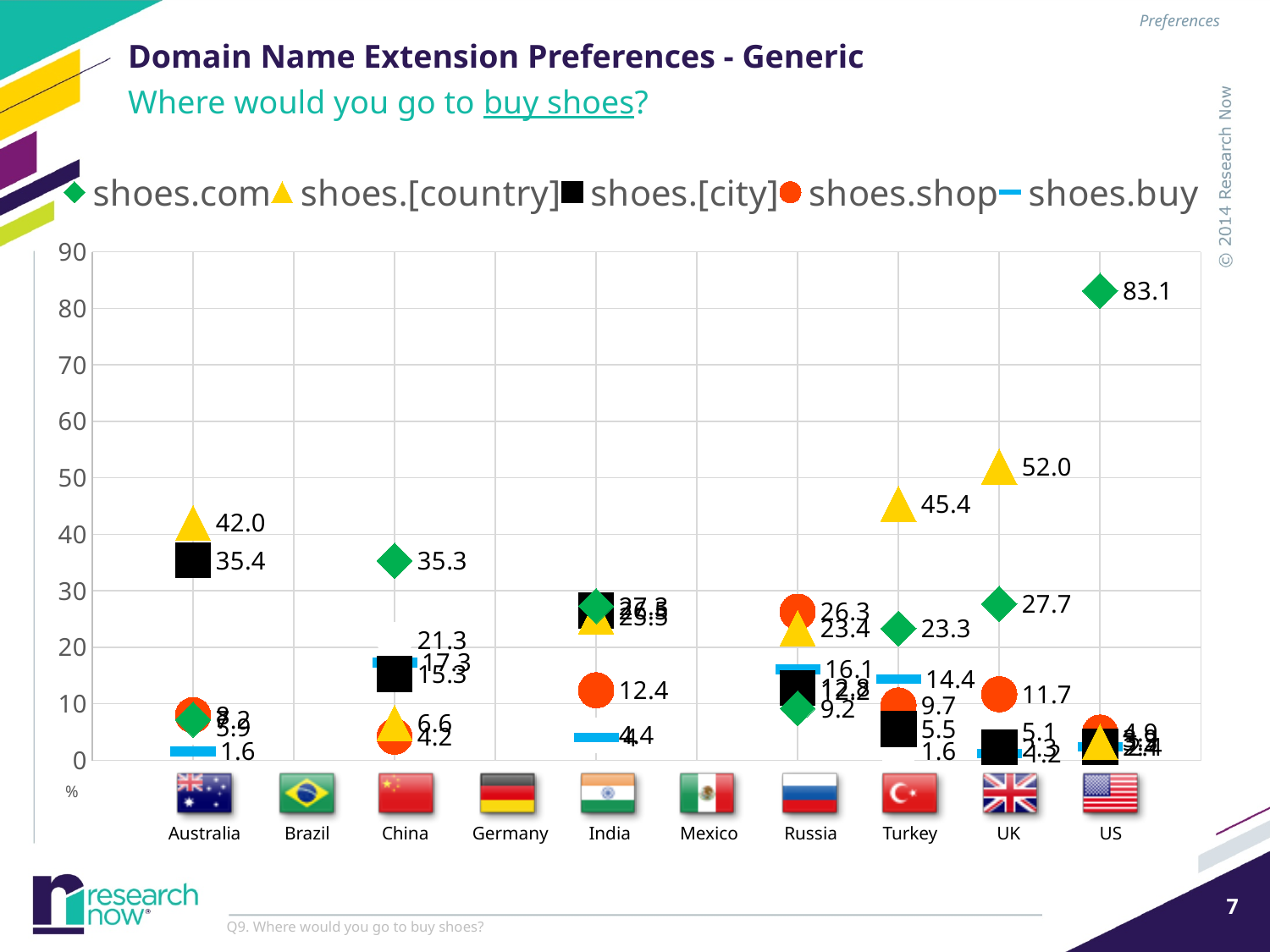
What is the value for shoes.buy in Turkey? 14.4 How many series does the legend list? 5 Which is larger: the shoes.[country] value for Turkey or for Australia? Turkey What is the value for shoes.[country] in Australia? 42.0 What kind of chart is shown on the slide? Scatter chart What is the value for shoes.[city] in Australia? 35.4 Which countries on the x axis have no data points plotted? Brazil, Germany, Mexico How many countries are shown along the x axis? 10 What is the value for shoes.[country] in the UK? 52.0 What is the value for shoes.com in the US? 83.1 What is the difference between the shoes.[country] values for the UK and Turkey? 6.6 Which country has the highest value for shoes.com? US